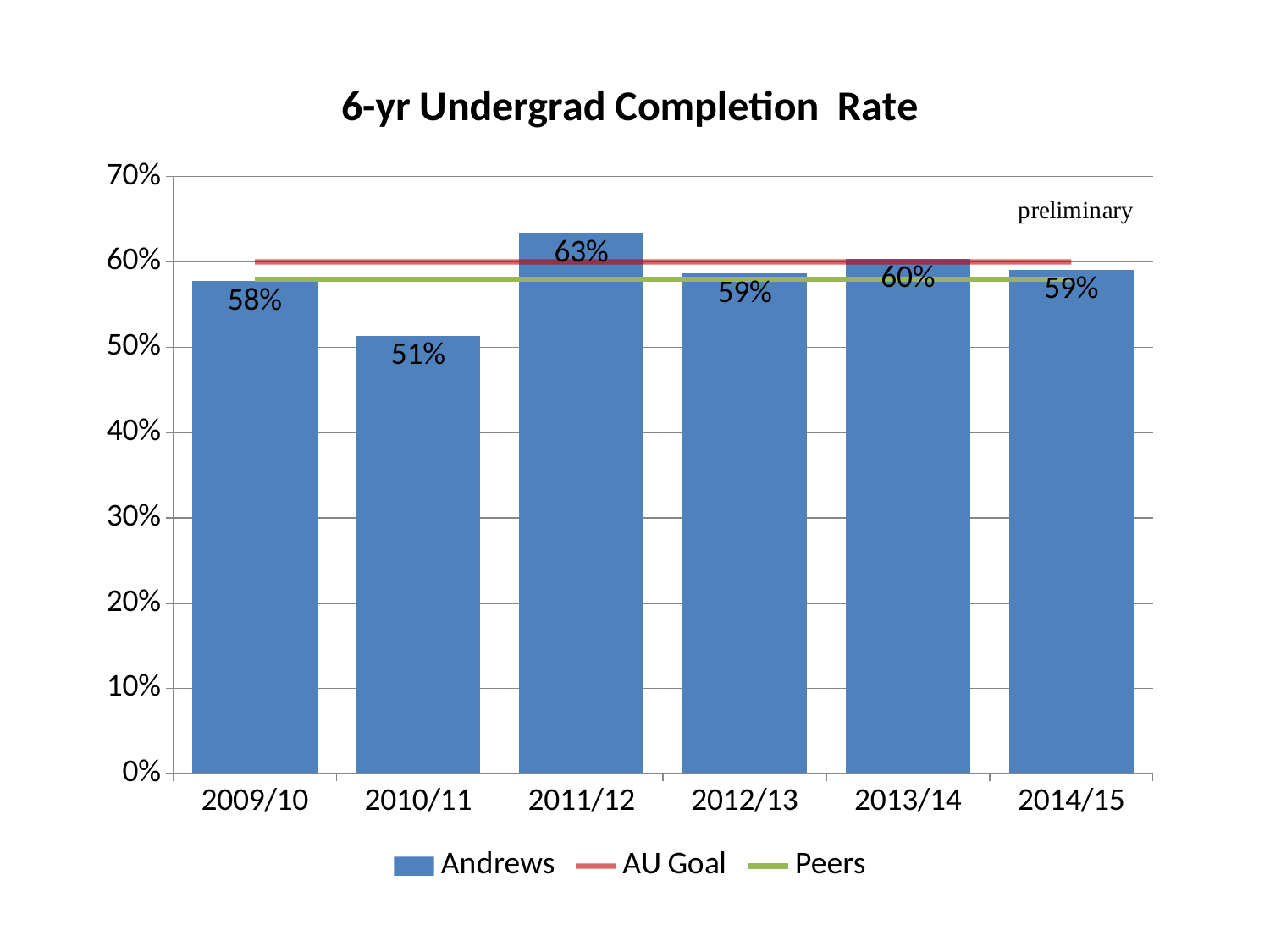
What is the Andrews completion rate shown for 2010/11? 51% Which is larger, the Andrews completion rate for 2009/10 or for 2013/14? 2013/14 Is the AU Goal line greater or less than 50%? greater Which year has the highest Andrews completion rate? 2011/12 Which year has the lowest Andrews completion rate? 2010/11 What kind of chart is used to show the Andrews completion rates? bar chart What is the title of the chart? 6-yr Undergrad Completion Rate How many series does the legend list? 3 What is the Andrews completion rate shown for 2013/14? 60% How many academic years are shown on the x axis? 6 What is the difference between the Andrews completion rate in 2011/12 and in 2010/11? 12% What is the Andrews 6-yr undergrad completion rate for 2011/12? 63%